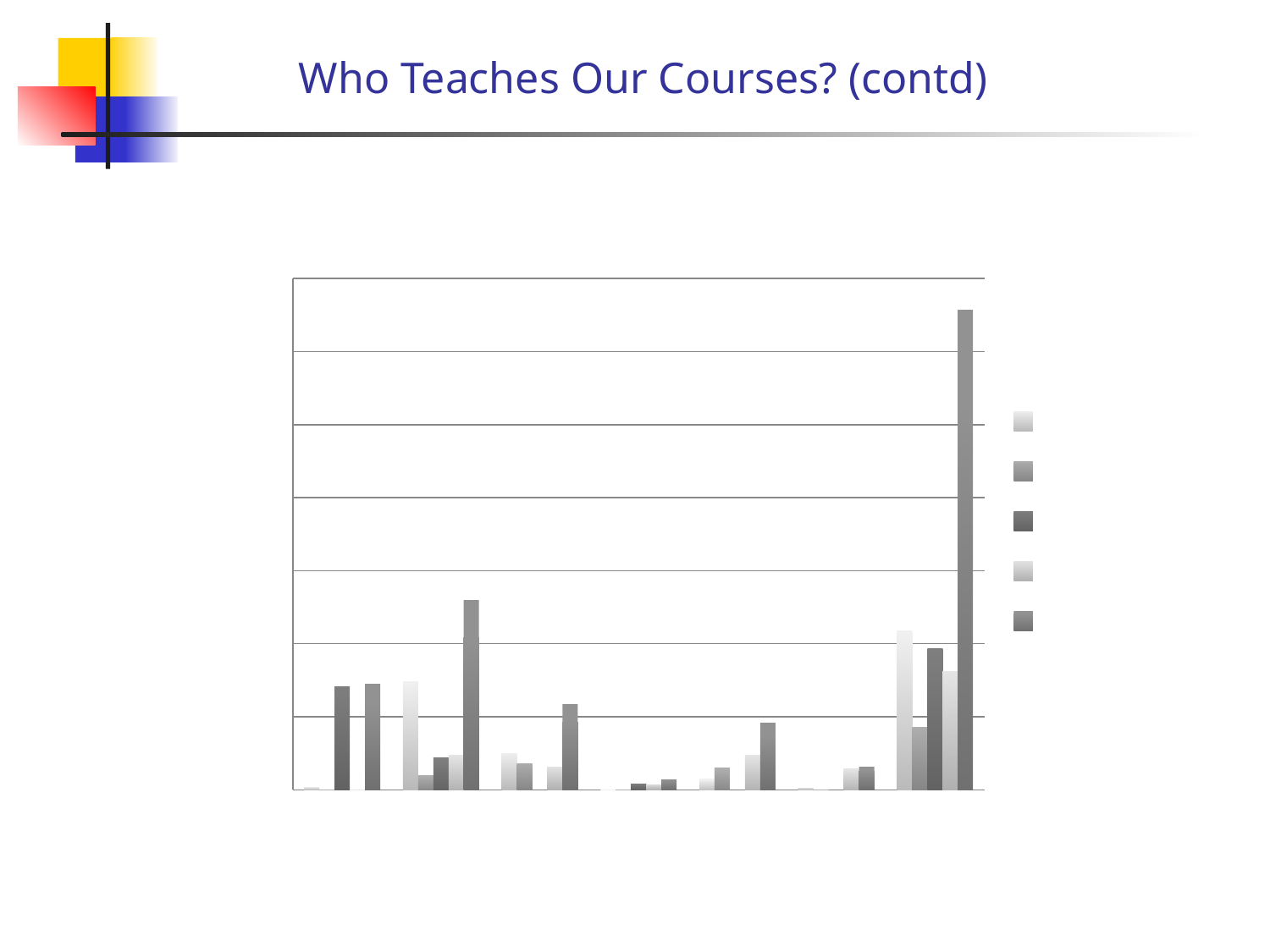
Does the chart display data labels on its bars? no Are the bars in the chart vertical or horizontal? vertical Which bar in the chart is the tallest? the rightmost bar What kind of chart is shown on the slide? bar chart How many series does the legend list? 5